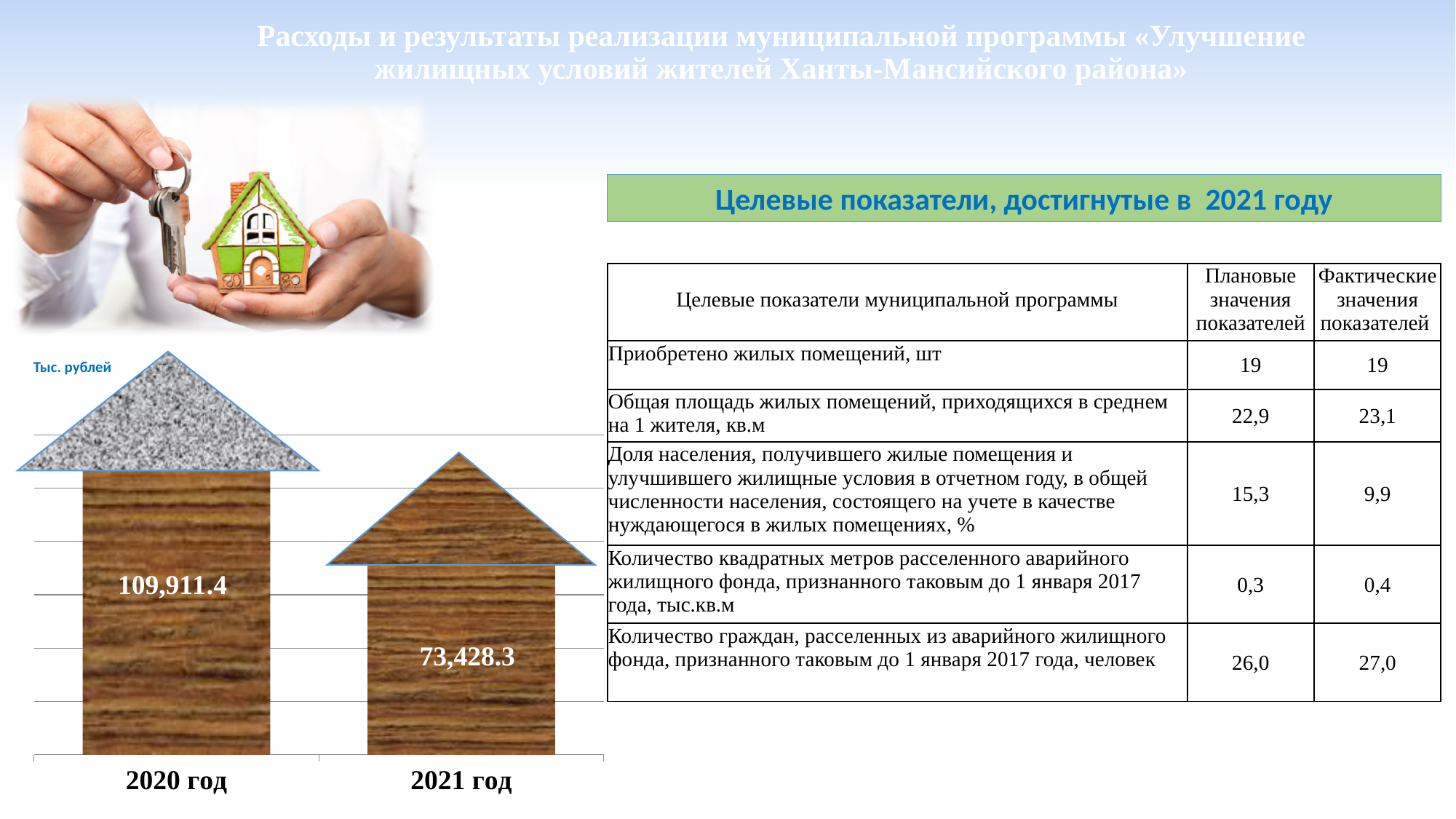
Which year has the highest value on the bar chart? 2020 год What unit label is shown above the bar chart? Тыс. рублей How many categories (years) are shown on the bar chart? 2 Which is larger on the bar chart: the value for 2020 год or for 2021 год? 2020 год What is the value for 2021 год on the bar chart? 73,428.3 What is the difference between the values for 2020 год and 2021 год on the bar chart? 36,483.1 What shape is drawn on top of each bar in the bar chart? A roof (triangle), making each bar look like a house Do the values on the bar chart rise or fall from 2020 год to 2021 год? Fall Which year has the lowest value on the bar chart? 2021 год What is the value for 2020 год on the bar chart? 109,911.4 What kind of chart is shown on the left of the slide? Bar chart